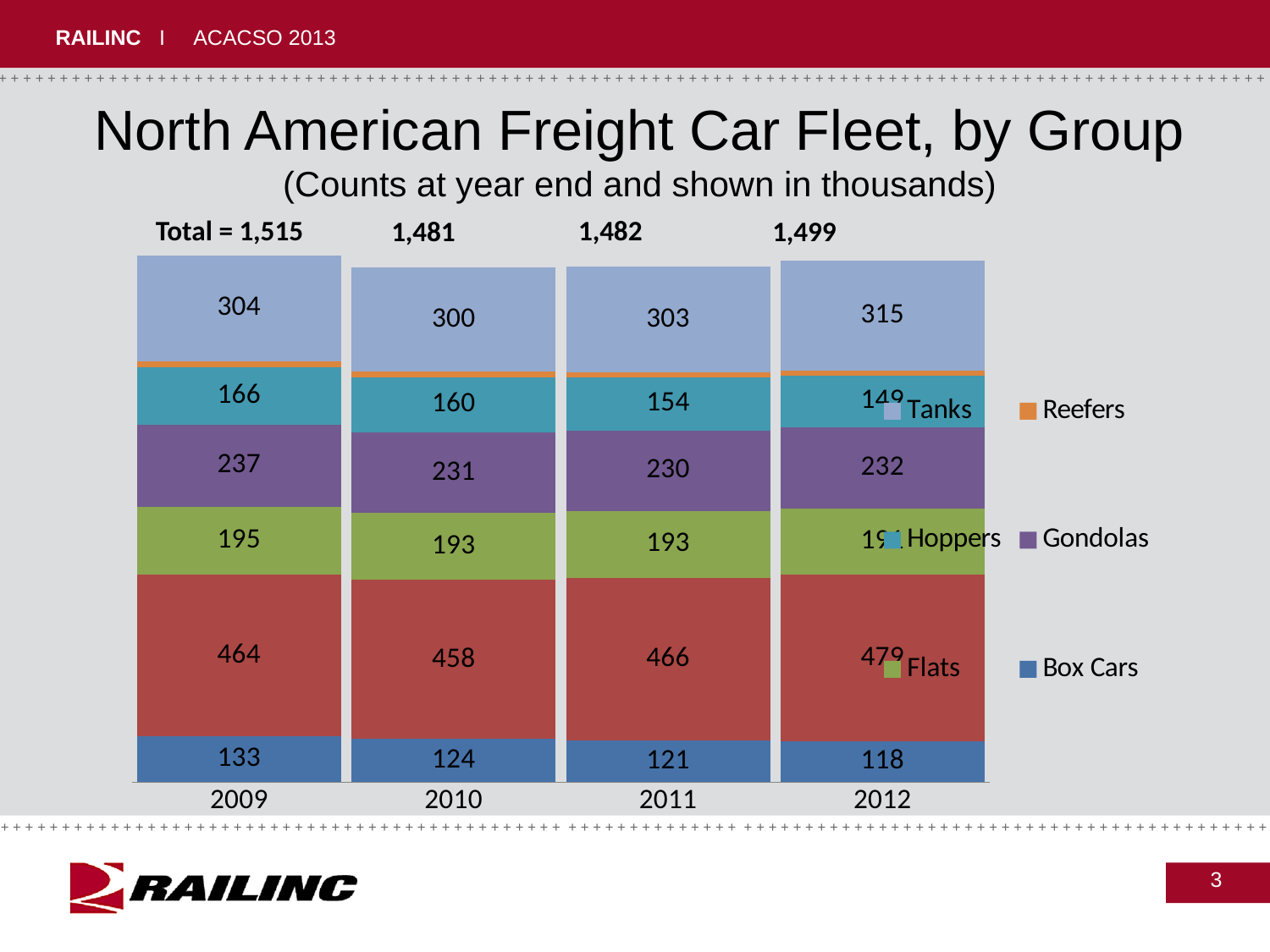
Do the Box Cars values rise or fall from 2009 to 2012? Fall Which year has the lowest total fleet count? 2010 How many series does the chart's legend list? 6 Which year has the highest total fleet count? 2009 What is the value for Gondolas in 2011? 230 What is the value for Tanks in 2012? 315 What is the value for Hoppers in 2011? 154 What is the total fleet count shown for 2010? 1,481 What is the difference between the Box Cars value in 2009 and in 2012? 15 What is the value for Box Cars in 2009? 133 How many years are shown along the x axis of the chart? 4 What kind of chart is shown on the slide? Stacked bar chart